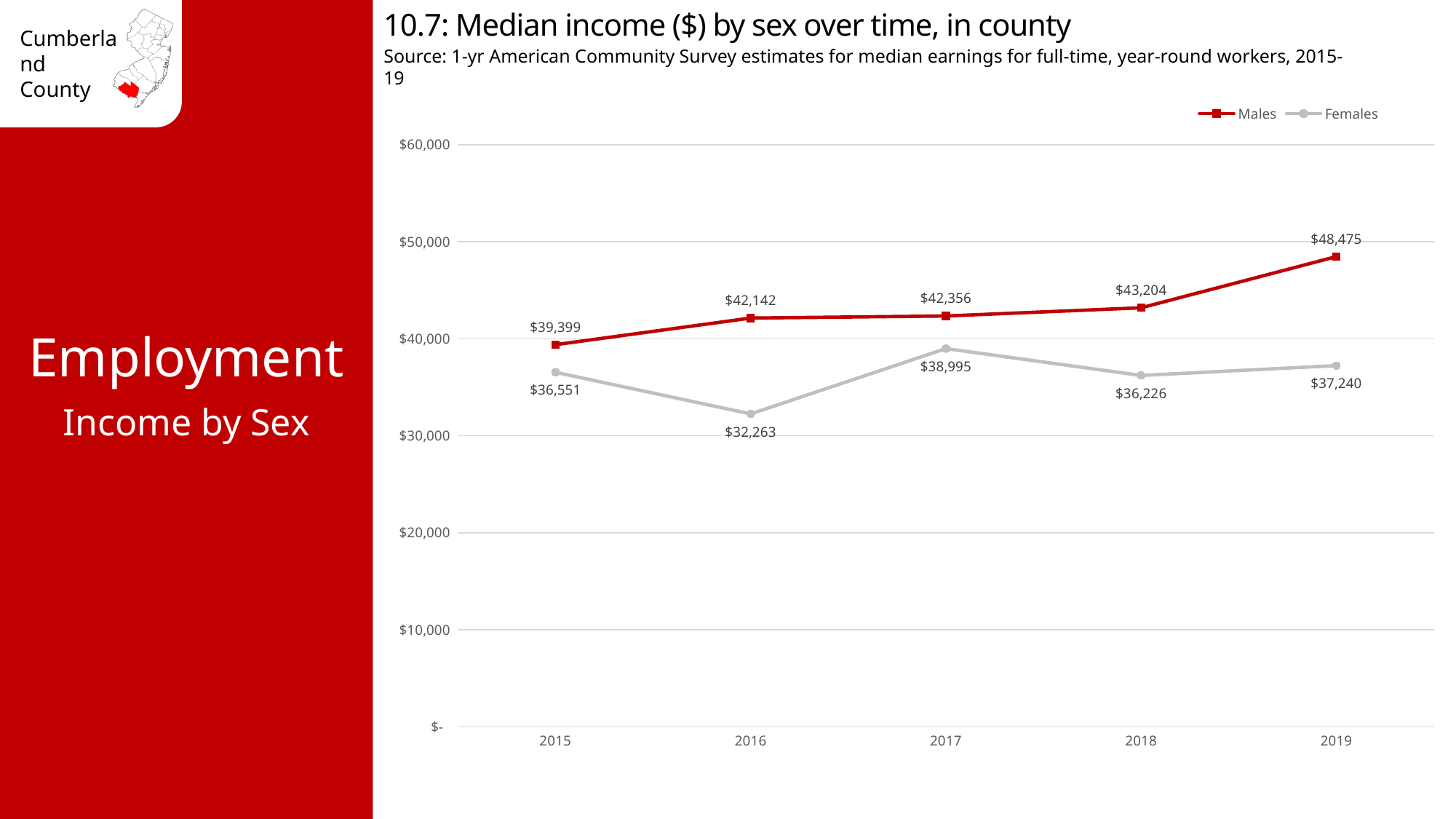
What is the difference between the Males and Females median income in 2019? $11,235 What was the median income for Females in 2016? $32,263 In which year was the Males median income highest? 2019 What colour is the Males line? Red What kind of chart is shown on the slide? Line chart Does the Males median income rise or fall from 2015 to 2019? Rise What was the median income for Males in 2015? $39,399 How many years are shown on the x axis? 5 How many series does the legend list? 2 What was the median income for Males in 2019? $48,475 Which series had the higher median income in 2017, Males or Females? Males In which year was the Females median income lowest? 2016